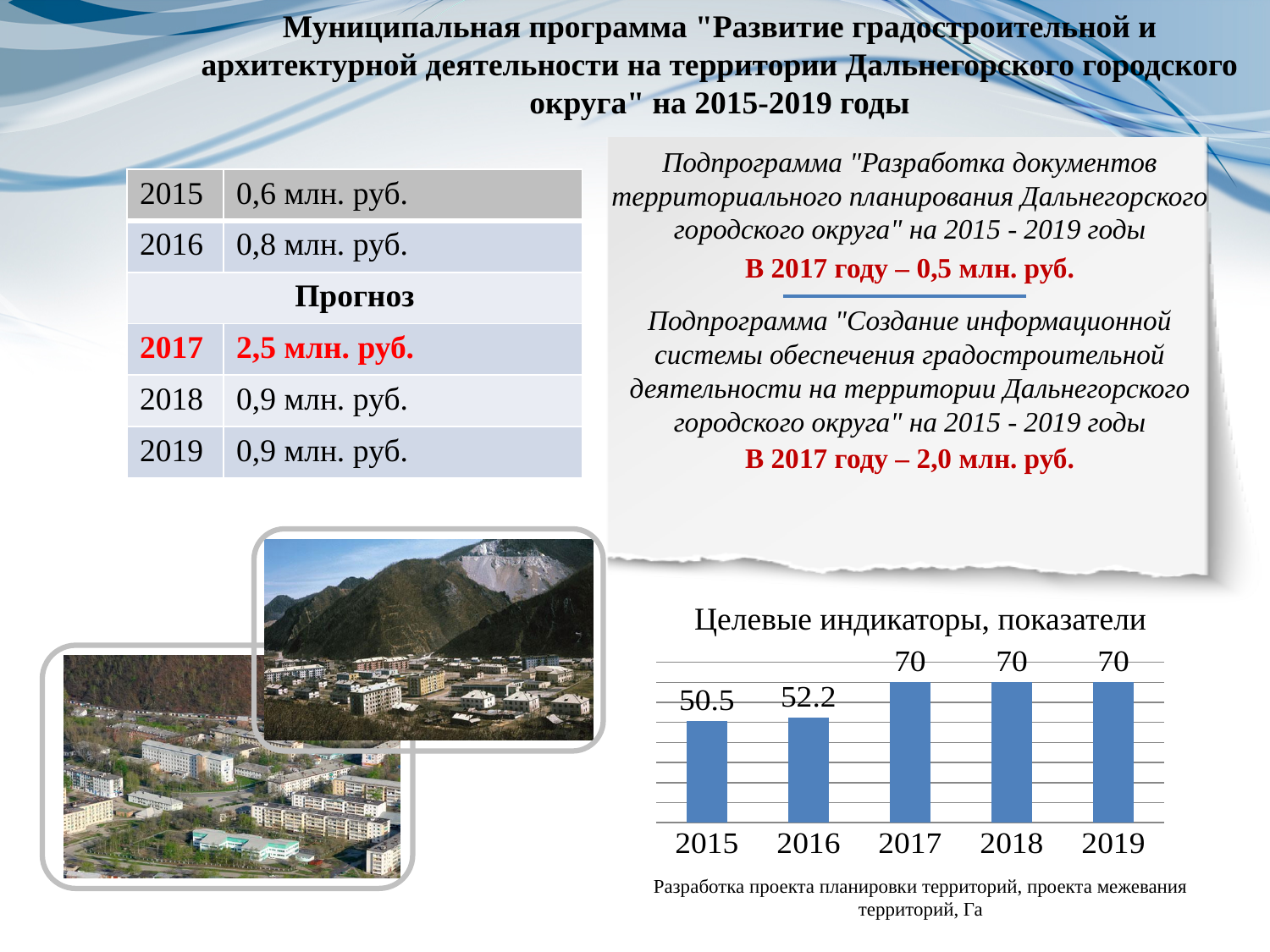
What is the difference between the values for 2016 and 2015 in the chart 'Целевые индикаторы, показатели'? 1.7 What is the value for 2017 in the chart 'Целевые индикаторы, показатели'? 70 What is the value for 2015 in the chart 'Целевые индикаторы, показатели'? 50.5 What is the value for 2019 in the chart 'Целевые индикаторы, показатели'? 70 What is the title of the bar chart on the slide? Целевые индикаторы, показатели What is the difference between the values for 2017 and 2015 in the chart 'Целевые индикаторы, показатели'? 19.5 Do the values in the chart 'Целевые индикаторы, показатели' rise or fall from 2015 to 2017? rise In the chart 'Целевые индикаторы, показатели', which is larger: the value for 2016 or the value for 2018? 2018 Which year has the lowest value in the chart 'Целевые индикаторы, показатели'? 2015 What kind of chart is 'Целевые индикаторы, показатели'? bar chart How many years are shown on the x axis of the chart 'Целевые индикаторы, показатели'? 5 What is the value for 2016 in the chart 'Целевые индикаторы, показатели'? 52.2